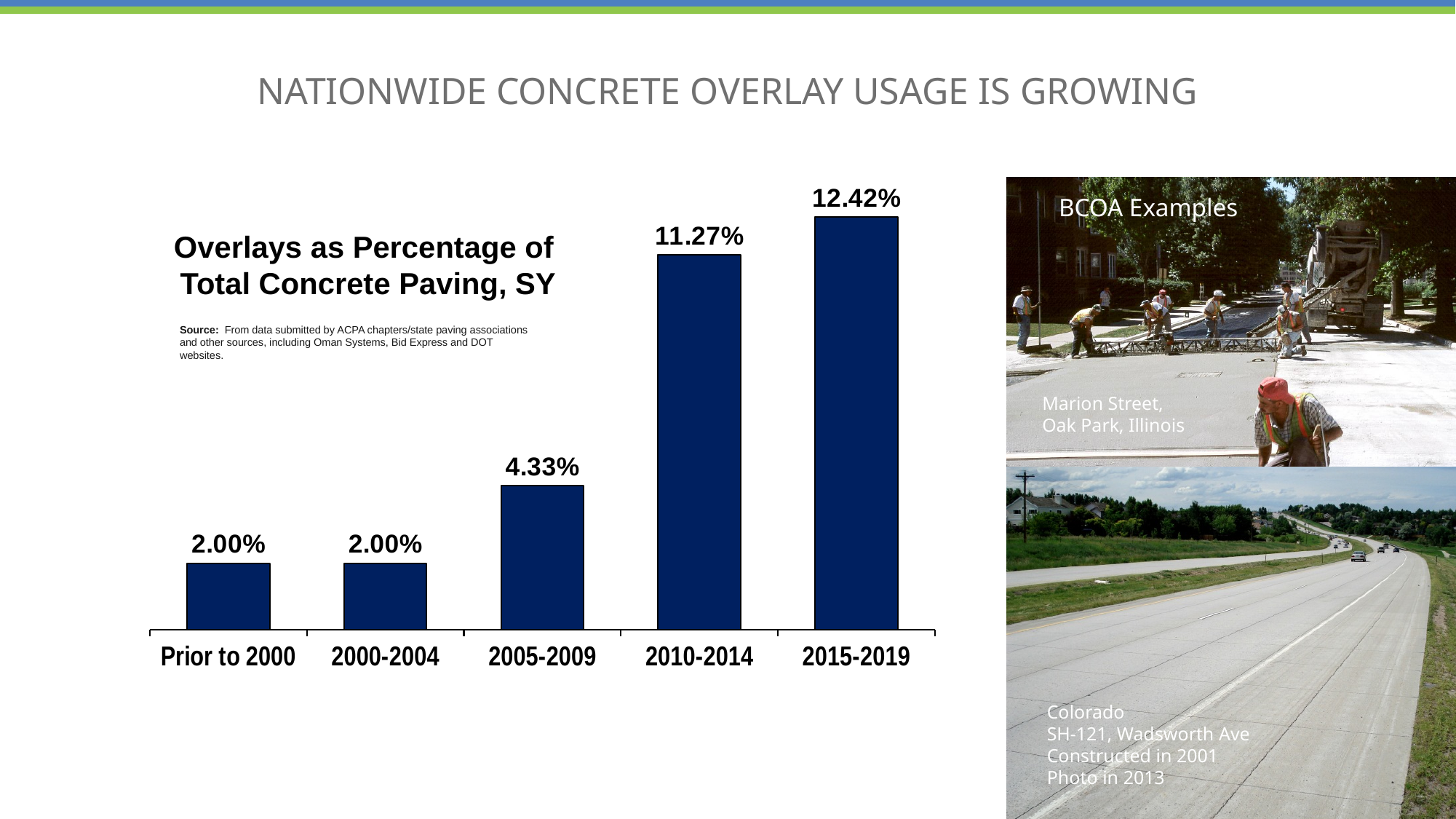
What is the value for Prior to 2000? 2.00% What kind of chart is this? Bar chart How many periods are shown on the x axis? 5 What is the value for 2005-2009? 4.33% What is the value for 2015-2019? 12.42% What is the difference between the values for 2015-2019 and 2010-2014? 1.15% What is the difference between the values for 2005-2009 and 2000-2004? 2.33% Do the values rise or fall from Prior to 2000 to 2015-2019? Rise Which is larger, the value for 2010-2014 or the value for 2005-2009? 2010-2014 What is the value for 2010-2014? 11.27% Which period has the highest value? 2015-2019 What is the title of the chart? Overlays as Percentage of Total Concrete Paving, SY